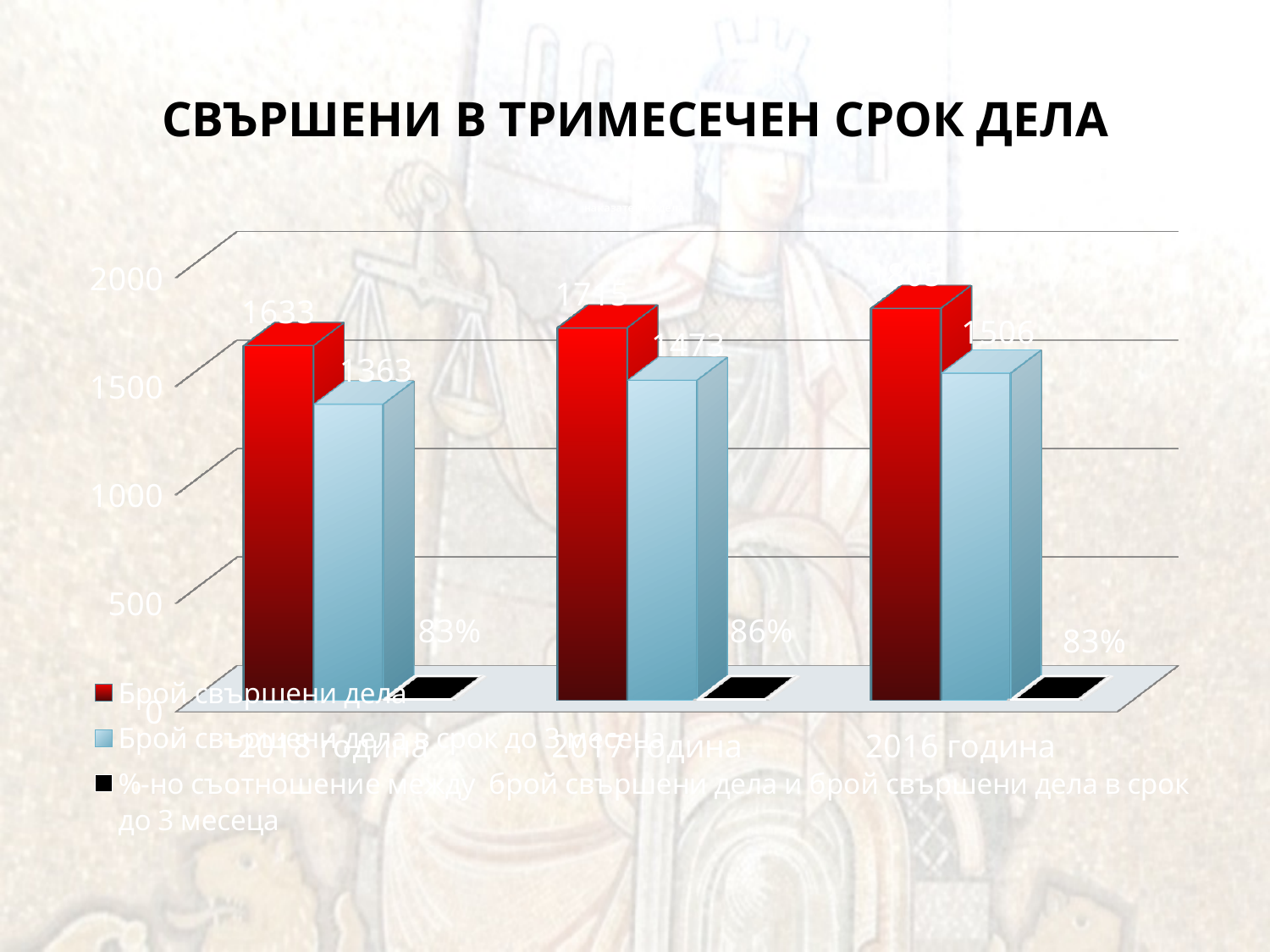
What is the value of "Брой свършени дела в срок до 3 месеца" for 2016 година? 1506 What is the difference between "Брой свършени дела" and "Брой свършени дела в срок до 3 месеца" for 2018 година? 270 What is the value of "Брой свършени дела в срок до 3 месеца" for 2018 година? 1363 What is the value of "Брой свършени дела" for 2018 година? 1633 Is the value of "Брой свършени дела" for 2017 година greater or less than 1500? greater Which year has the lowest value for "Брой свършени дела в срок до 3 месеца"? 2018 година How many series does the legend list? 3 What percentage is shown for 2018 година? 83% What percentage is shown for 2017 година? 86% What is the value of "Брой свършени дела в срок до 3 месеца" for 2017 година? 1473 What kind of chart is shown on the slide? bar chart Which year has the highest value for "Брой свършени дела в срок до 3 месеца"? 2016 година